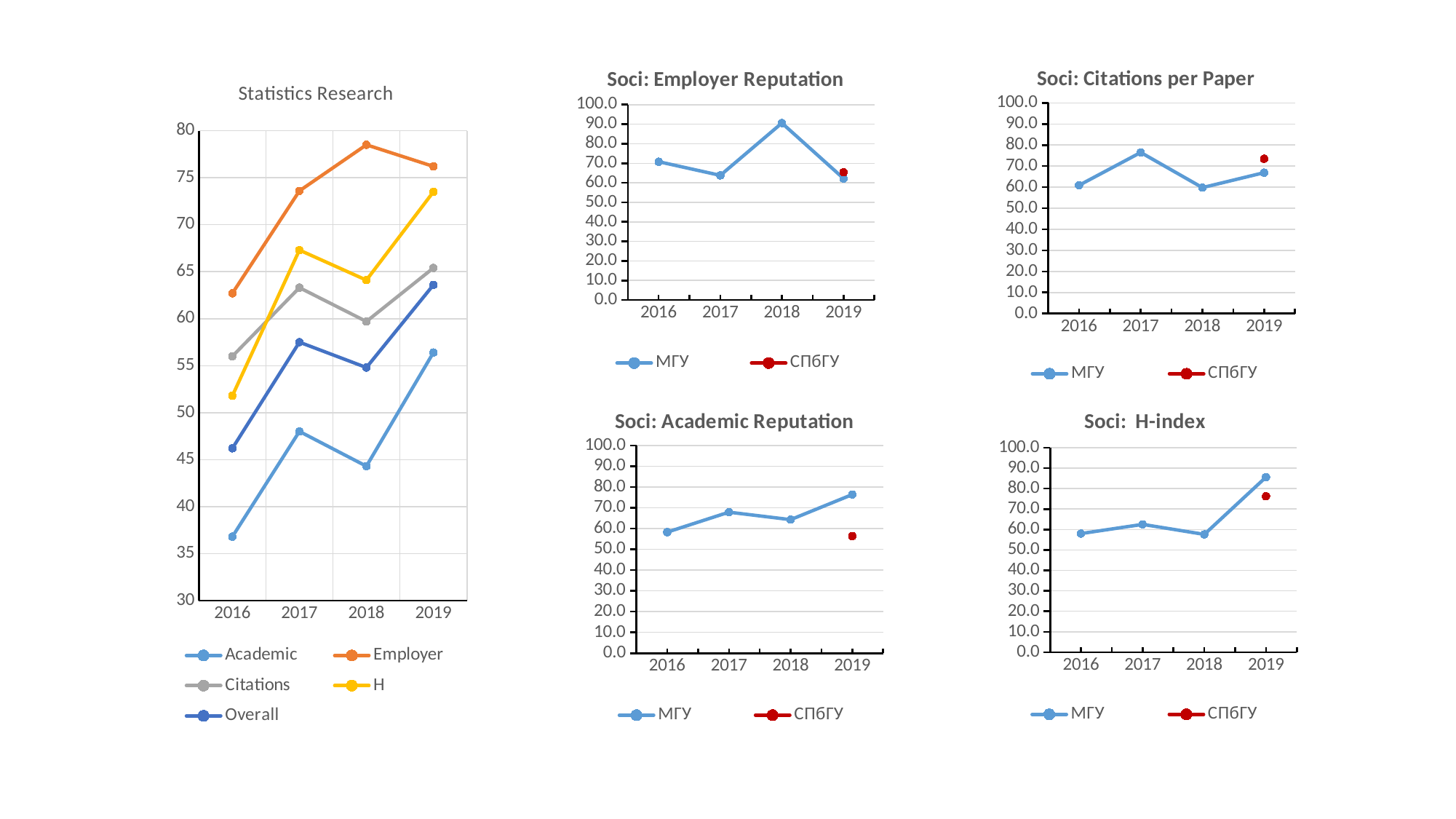
In the 'Statistics Research' chart, which series has the lowest value in 2016? Academic How many series does the legend of the 'Statistics Research' chart list? 5 In the 'Statistics Research' chart, is the Academic value for 2016 greater or less than 40? less In the 'Statistics Research' chart, in which year does the Employer series reach its highest value? 2018 In the 'Soci: Employer Reputation' chart, in which year is the МГУ value highest? 2018 In the 'Soci: Academic Reputation' chart, which is larger in 2019, the МГУ value or the СПбГУ value? МГУ In the 'Statistics Research' chart, which series has the highest value in 2019? Employer In the 'Statistics Research' chart, is the Employer value for 2017 greater or less than 70? greater How many series does the legend of the 'Soci: H-index' chart list? 2 In the 'Soci: Citations per Paper' chart, which is larger in 2019, the МГУ value or the СПбГУ value? СПбГУ What kind of chart is the 'Statistics Research' chart? line chart In the 'Soci: Employer Reputation' chart, is the МГУ value for 2018 greater or less than 80.0? greater